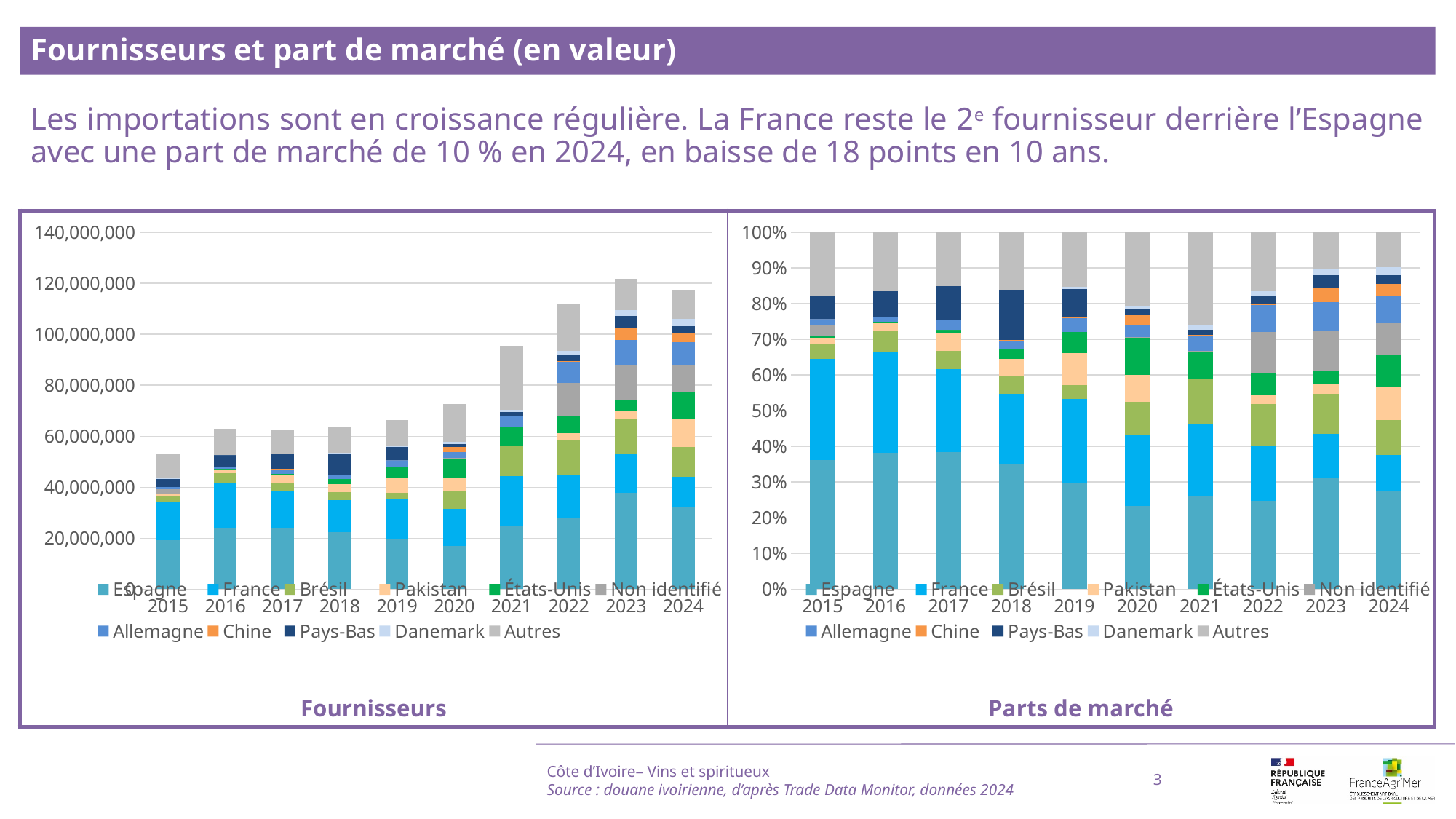
In the 'Parts de marché' chart, is the Espagne share in 2016 greater or less than 30%? greater How many series does the legend of the 'Fournisseurs' chart list? 11 In the 'Fournisseurs' chart, is the total bar for 2024 greater or less than 120,000,000? less In the 'Fournisseurs' chart, which year has the shortest stacked bar? 2015 In the 'Fournisseurs' chart, which year has the tallest stacked bar? 2023 In the 'Fournisseurs' chart, do the total bars generally rise or fall from 2015 to 2024? rise What is the title of the chart on the right side of the slide? Parts de marché In the 'Fournisseurs' chart, is the total bar for 2021 greater or less than 100,000,000? less How many years are shown on the x axis of the 'Parts de marché' chart? 10 In the 'Fournisseurs' chart, which year has the larger total bar, 2023 or 2024? 2023 What kind of chart is the 'Fournisseurs' chart on the left? stacked bar chart